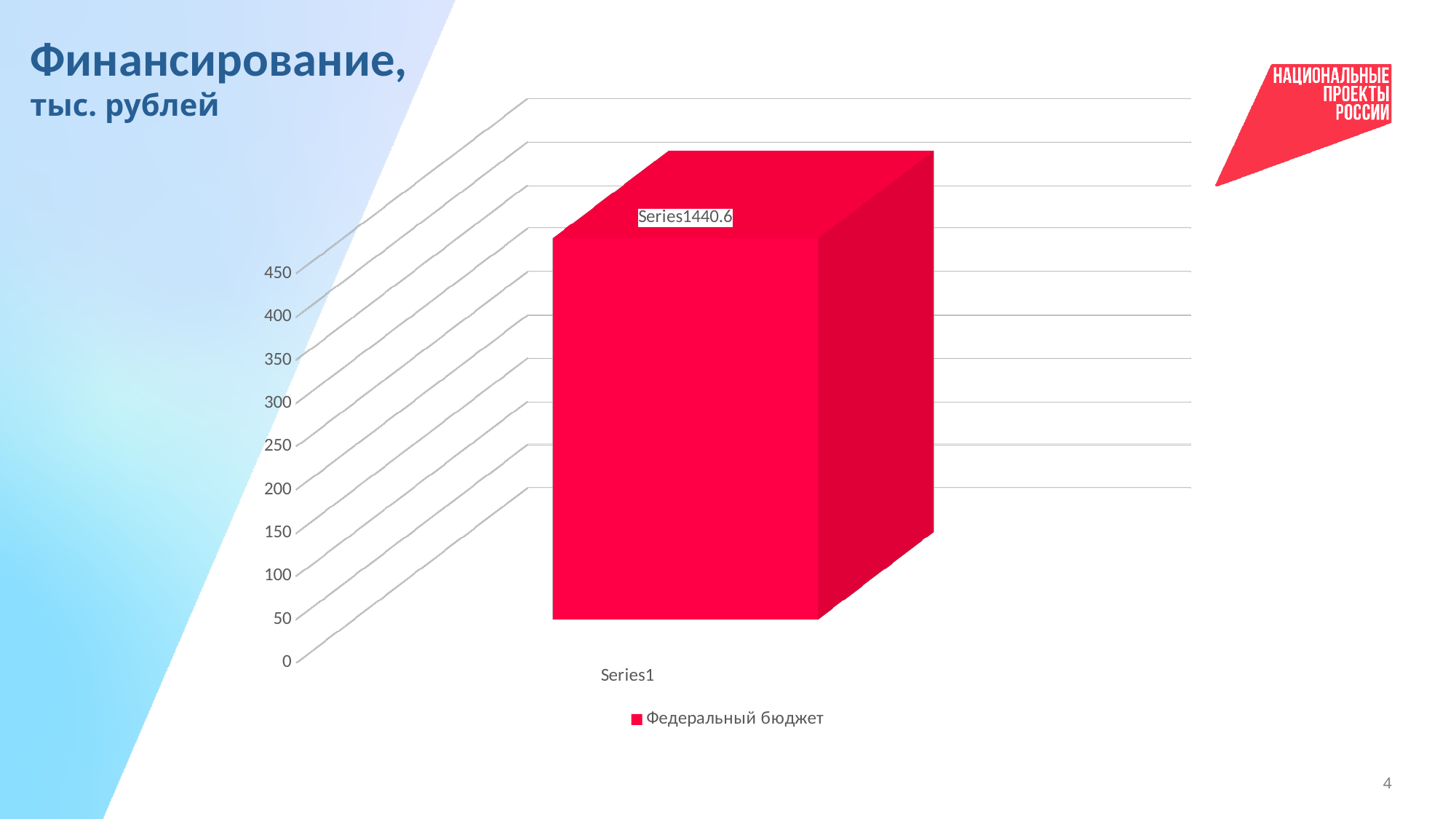
What value is shown by the data label on the bar in the chart? 440.6 What is the name of the series shown in the chart legend? Федеральный бюджет What kind of chart is shown on the slide? bar chart Is the value of the bar greater or less than 400? greater How many series does the chart legend list? 1 How many bars are plotted in the chart? 1 What is the category label shown on the x axis of the chart? Series1 Is the value of the bar greater or less than 450? less What is the highest tick value shown on the vertical axis of the chart? 450